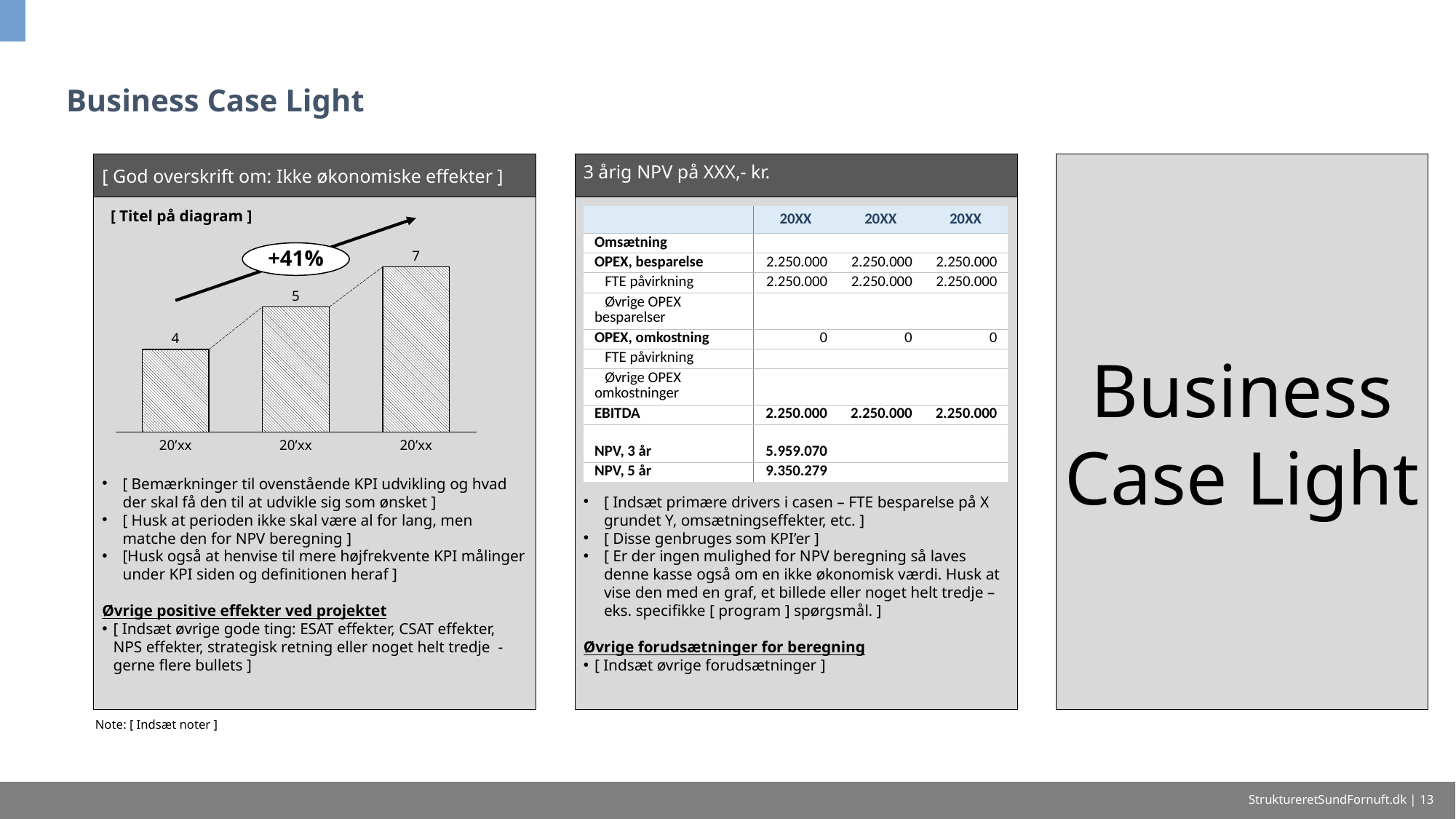
What kind of chart is shown in the left panel under "[ Titel på diagram ]"? bar chart What is the value of the third (rightmost) bar in the chart? 7 What is the value of the middle bar in the chart? 5 Which is larger in the chart: the middle bar or the rightmost bar? the rightmost bar What label is used for each category on the x axis of the chart? 20'xx Which bar in the chart has the highest value? the third (rightmost) bar What percentage is shown in the oval annotation above the bars in the chart? +41% Which bar in the chart has the lowest value? the first (leftmost) bar Do the bar values rise or fall from left to right in the chart? rise What is the value of the first (leftmost) bar in the chart? 4 How many bars does the chart in the left panel have? 3 What is the difference between the rightmost bar and the leftmost bar in the chart? 3